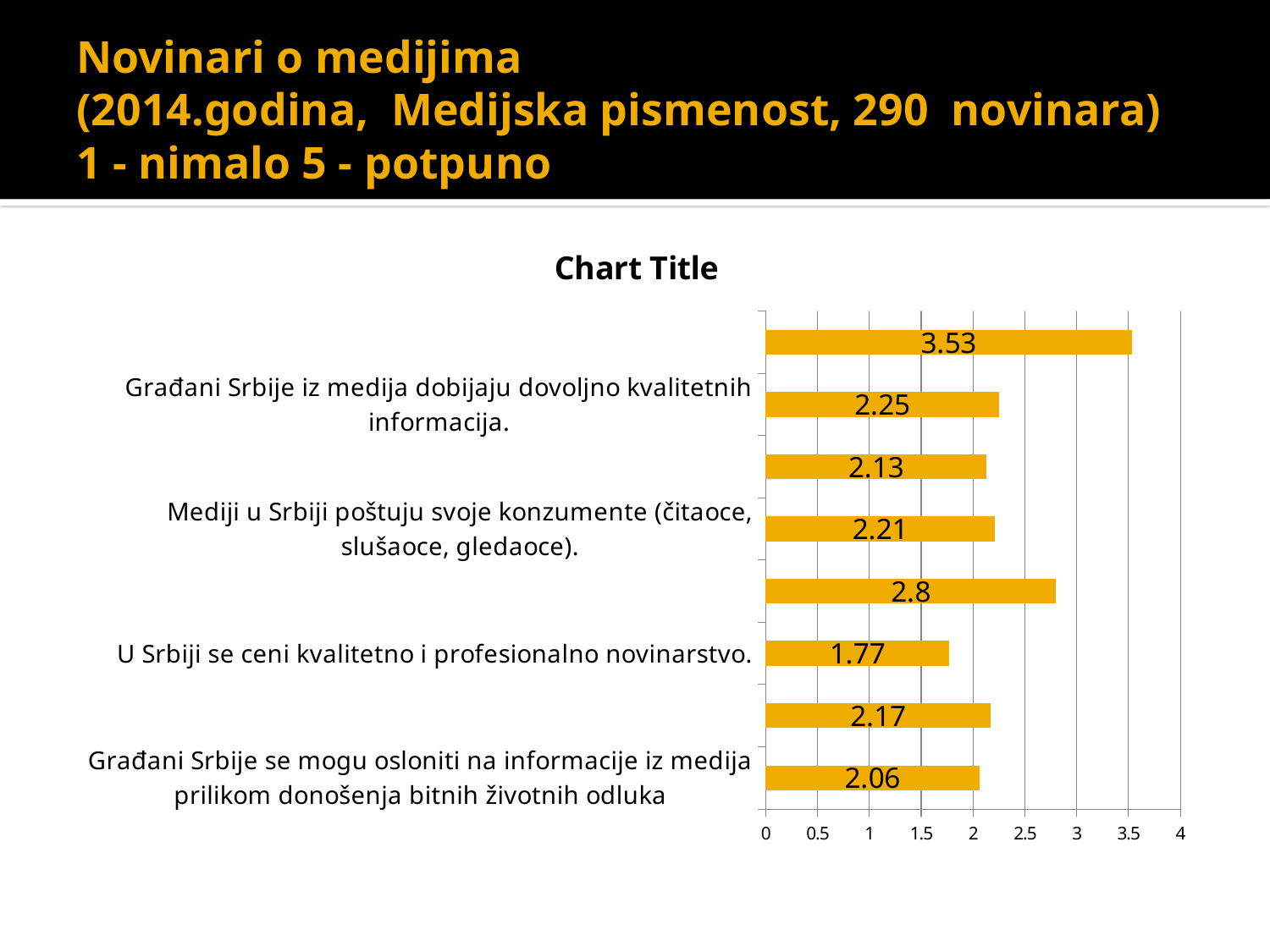
What is the value for "Građani Srbije se mogu osloniti na informacije iz medija prilikom donošenja bitnih životnih odluka"? 2.06 How many bars are plotted on the chart? 8 What is the highest value shown on the chart? 3.53 What is the value for "Mediji u Srbiji poštuju svoje konzumente (čitaoce, slušaoce, gledaoce)."? 2.21 What is the value for "U Srbiji se ceni kvalitetno i profesionalno novinarstvo."? 1.77 What is the value for "Građani Srbije iz medija dobijaju dovoljno kvalitetnih informacija."? 2.25 Which is larger: the value for "Mediji u Srbiji poštuju svoje konzumente (čitaoce, slušaoce, gledaoce)." or for "U Srbiji se ceni kvalitetno i profesionalno novinarstvo."? Mediji u Srbiji poštuju svoje konzumente (čitaoce, slušaoce, gledaoce). What kind of chart is shown on the slide? bar chart What is the difference between the values for "Građani Srbije iz medija dobijaju dovoljno kvalitetnih informacija." and "Građani Srbije se mogu osloniti na informacije iz medija prilikom donošenja bitnih životnih odluka"? 0.19 Which labelled category has the lowest value? U Srbiji se ceni kvalitetno i profesionalno novinarstvo. What is the title printed above the chart? Chart Title Is the value for "U Srbiji se ceni kvalitetno i profesionalno novinarstvo." greater or less than 2? less